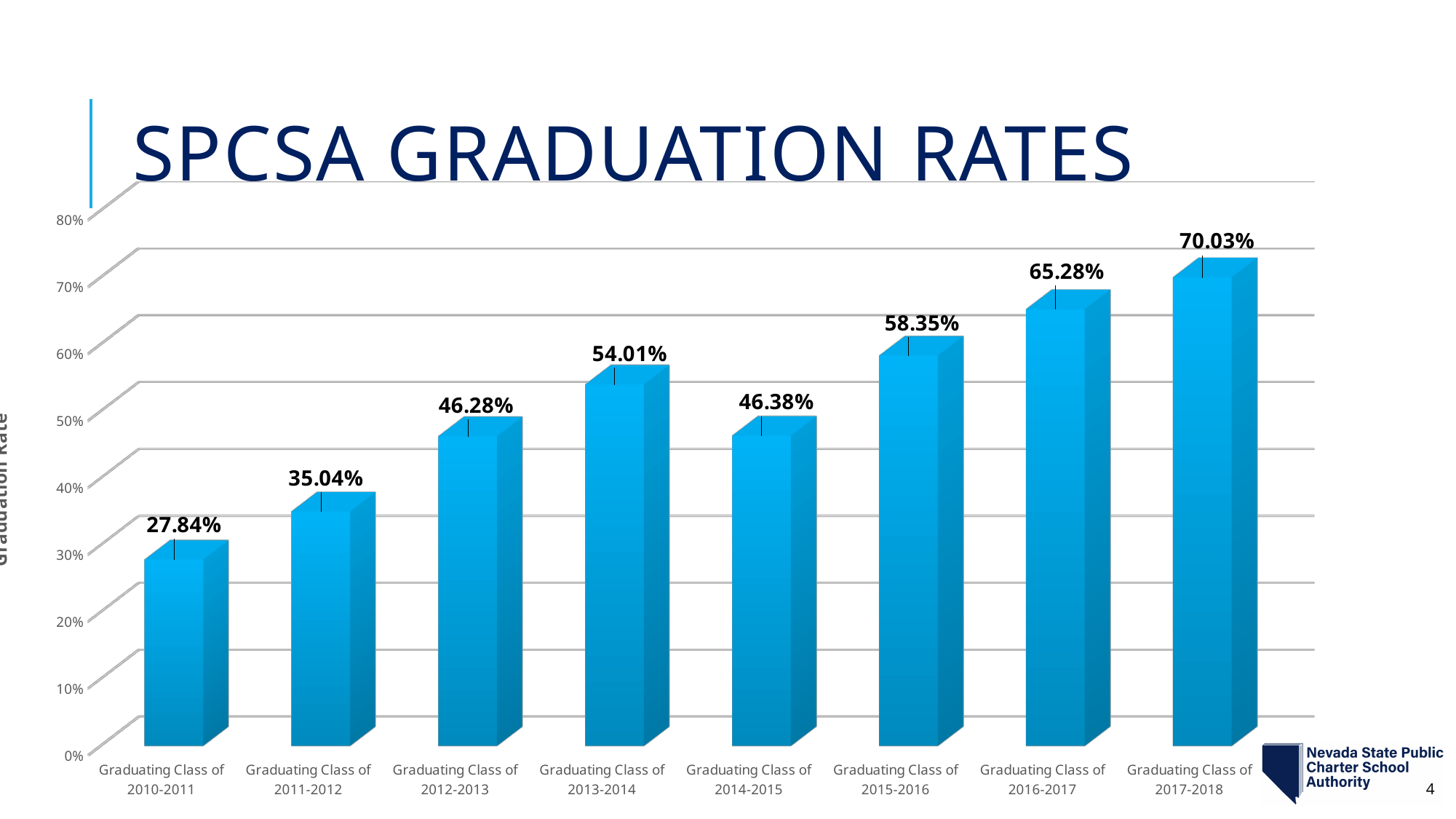
Which graduating class has the lowest graduation rate? Graduating Class of 2010-2011 Which graduating class has the highest graduation rate? Graduating Class of 2017-2018 What is the graduation rate for the Graduating Class of 2010-2011? 27.84% How many graduating classes are shown in the chart? 8 What is the title of the chart on the slide? SPCSA Graduation Rates What is the graduation rate for the Graduating Class of 2017-2018? 70.03% Which has a higher graduation rate, the Graduating Class of 2013-2014 or the Graduating Class of 2014-2015? Graduating Class of 2013-2014 Is the graduation rate for the Graduating Class of 2011-2012 greater or less than 40%? less What is the graduation rate for the Graduating Class of 2014-2015? 46.38% What kind of chart is shown on the slide? Bar chart What is the difference in graduation rate between the Graduating Class of 2016-2017 and the Graduating Class of 2015-2016? 6.93% What is the difference in graduation rate between the Graduating Class of 2017-2018 and the Graduating Class of 2010-2011? 42.19%